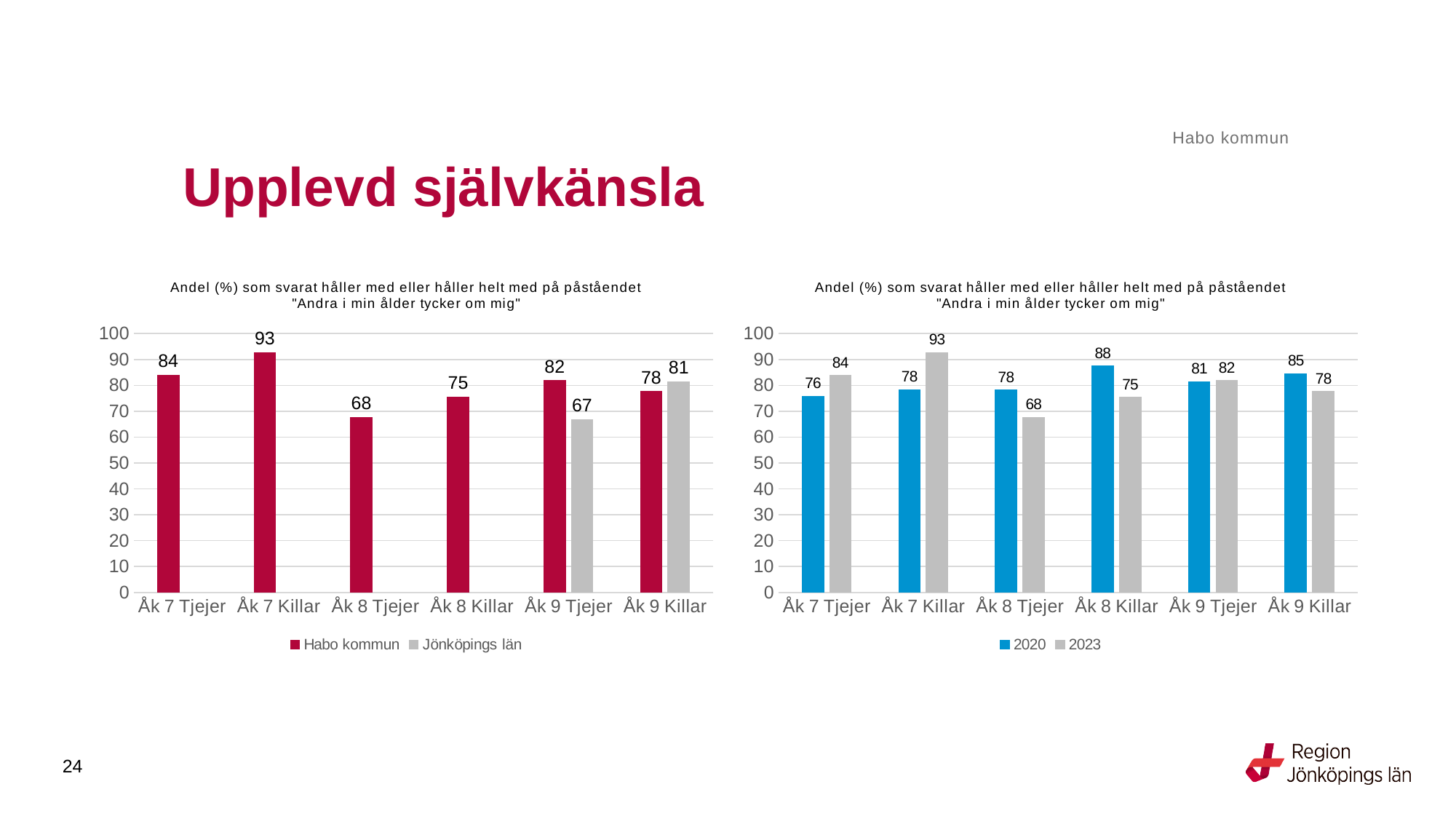
In the left chart, what is the value for Jönköpings län for Åk 9 Tjejer? 67 In the right chart, what is the difference between the 2020 and 2023 values for Åk 8 Killar? 13 In the left chart, which category has the lowest Habo kommun value? Åk 8 Tjejer In the left chart, what is the value for Habo kommun for Åk 7 Killar? 93 In the right chart, how many categories are shown on the x axis? 6 In the right chart, what is the 2023 value for Åk 7 Tjejer? 84 In the left chart, for Åk 9 Killar, which is larger: Habo kommun or Jönköpings län? Jönköpings län In the right chart, what is the 2020 value for Åk 8 Killar? 88 In the left chart, how many series does the legend list? 2 What kind of chart is the right chart? Bar chart In the right chart, which category has the highest 2023 value? Åk 7 Killar In the left chart, what is the difference between the Habo kommun values for Åk 7 Killar and Åk 8 Tjejer? 25